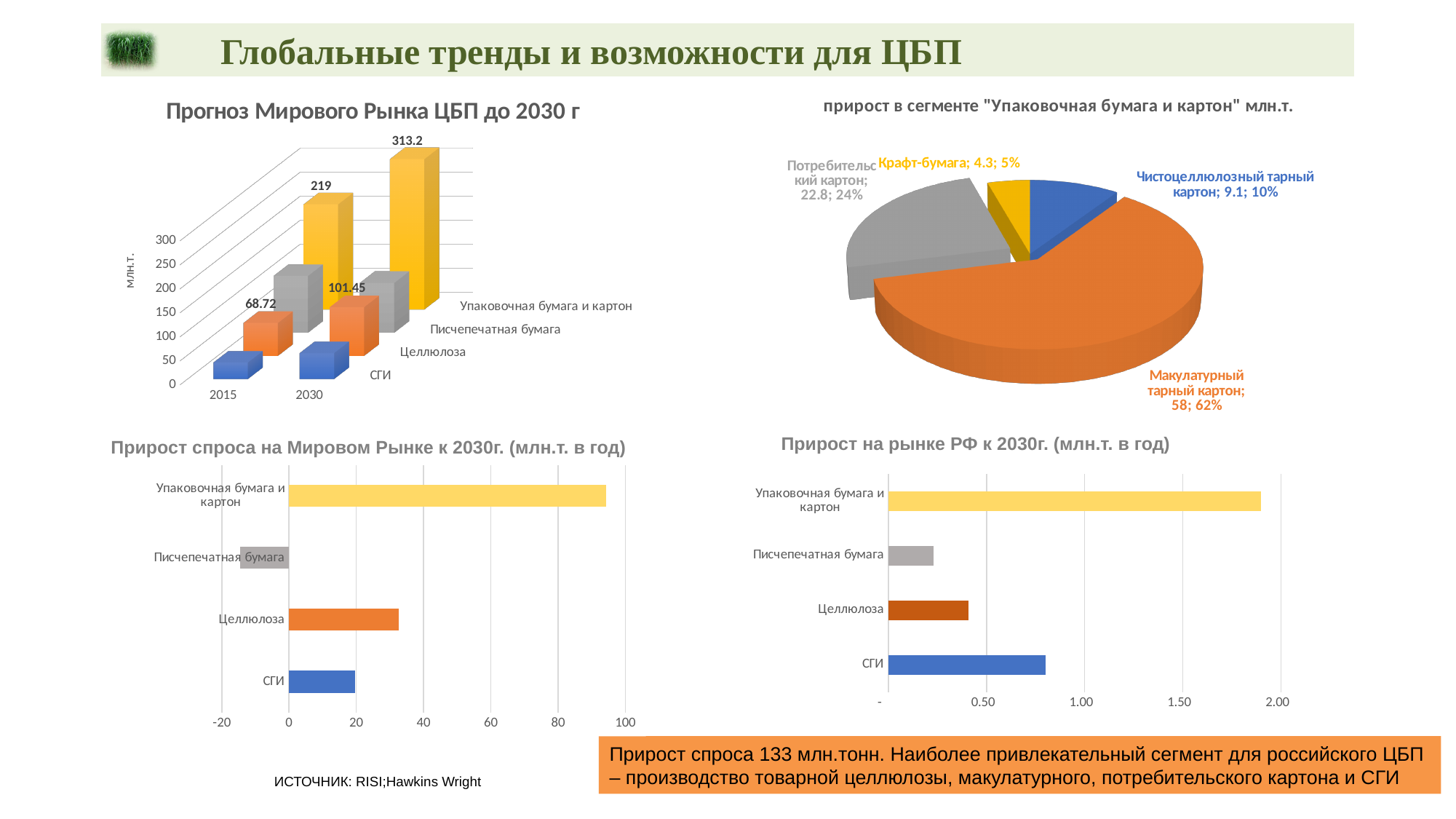
In the chart titled "Прирост спроса на Мировом Рынке к 2030г. (млн.т. в год)", is the value for Упаковочная бумага и картон greater or less than 80? greater In the chart titled "Прогноз Мирового Рынка ЦБП до 2030 г", what is the value for Целлюлоза in 2015? 68.72 In the pie chart titled "прирост в сегменте "Упаковочная бумага и картон" млн.т.", what is the value for Потребительский картон? 22.8 In the pie chart titled "прирост в сегменте "Упаковочная бумага и картон" млн.т.", which slice is the smallest? Крафт-бумага In the pie chart titled "прирост в сегменте "Упаковочная бумага и картон" млн.т.", what share does Макулатурный тарный картон have? 62% In the chart titled "Прирост на рынке РФ к 2030г. (млн.т. в год)", is the value for СГИ greater or less than 1.00? less In the chart titled "Прогноз Мирового Рынка ЦБП до 2030 г", what is the value for Упаковочная бумага и картон in 2030? 313.2 In the chart titled "Прирост спроса на Мировом Рынке к 2030г. (млн.т. в год)", which is larger, Целлюлоза or СГИ? Целлюлоза In the chart titled "Прирост спроса на Мировом Рынке к 2030г. (млн.т. в год)", which category has the lowest value? Писчепечатная бумага How many slices does the pie chart titled "прирост в сегменте "Упаковочная бумага и картон" млн.т." have? 4 In the chart titled "Прирост на рынке РФ к 2030г. (млн.т. в год)", which category has the highest value? Упаковочная бумага и картон In the chart titled "Прогноз Мирового Рынка ЦБП до 2030 г", by how much does Упаковочная бумага и картон grow from 2015 to 2030? 94.2